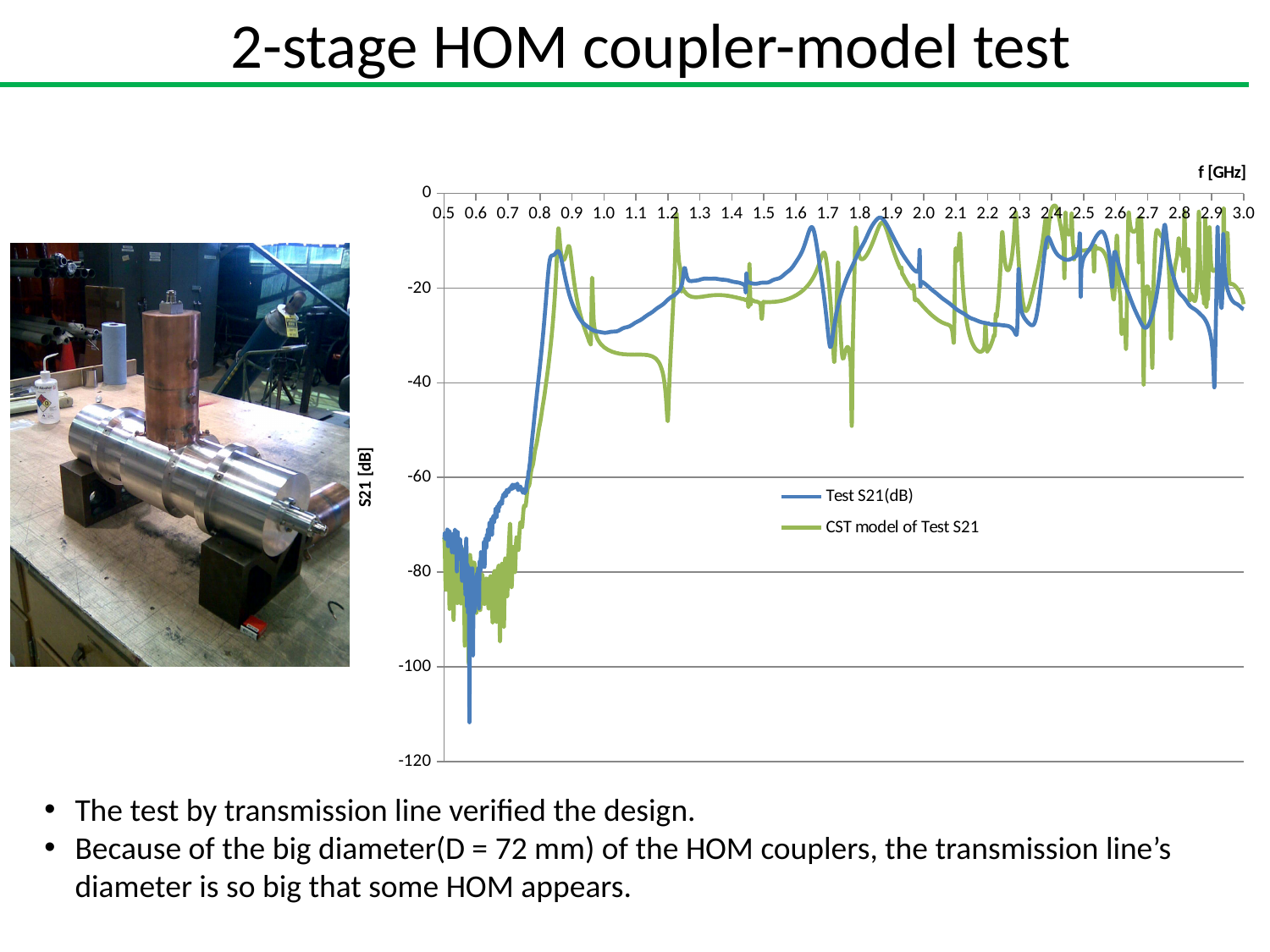
Is the peak of Test S21(dB) near 1.9 GHz greater or less than -20? greater Between 0.5 GHz and 0.9 GHz, do the Test S21(dB) values rise or fall? rise Is the value of Test S21(dB) at 1.0 GHz greater or less than -40? greater Is the value of CST model of Test S21 at 0.5 GHz greater or less than -60? less Which series is drawn in blue on the chart? Test S21(dB) What kind of chart is shown on the slide? line chart What are the two series named in the chart legend? Test S21(dB) and CST model of Test S21 What is the label of the vertical axis of the chart? S21 [dB] How many series does the chart legend list? 2